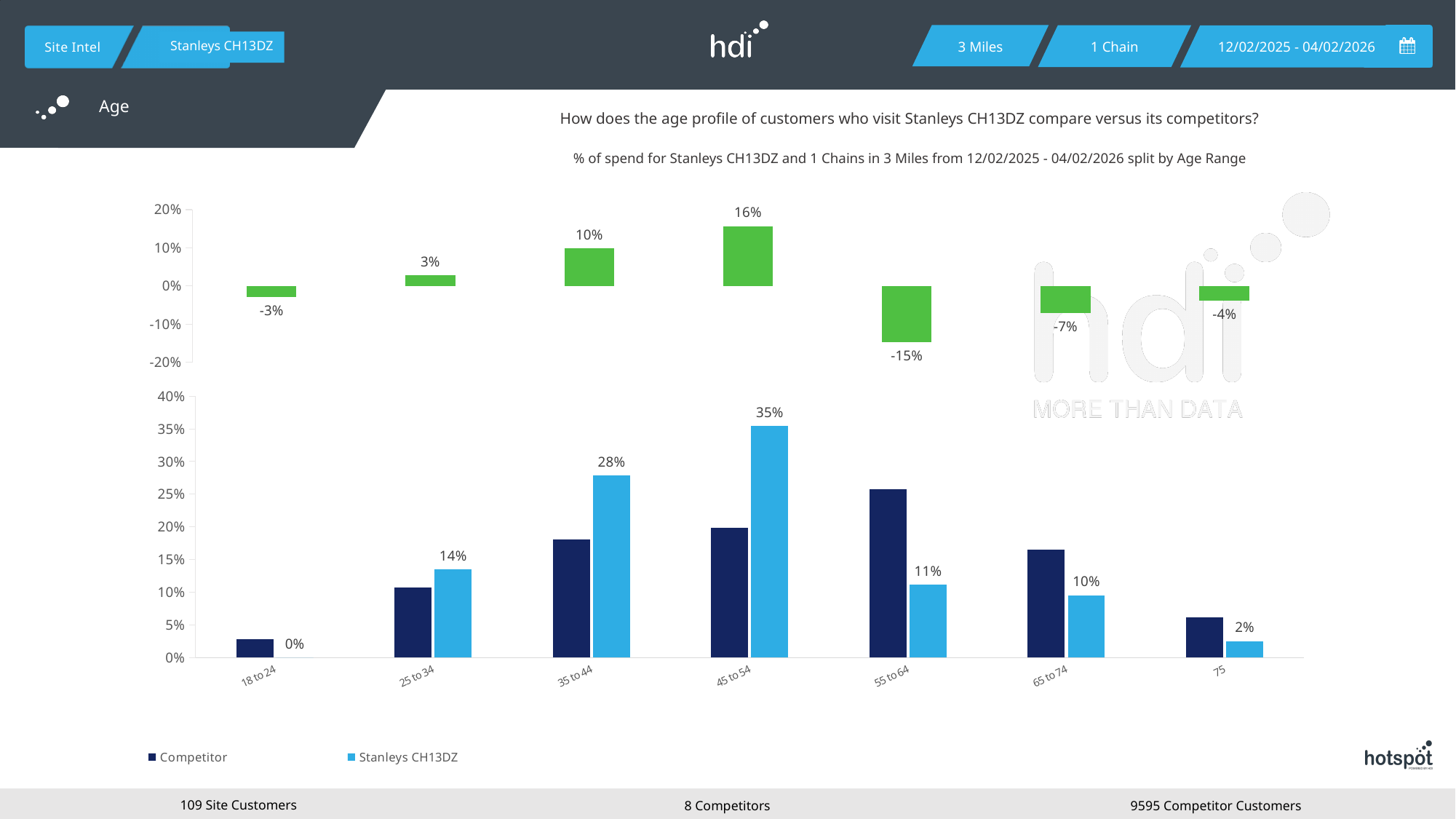
In the bottom chart, what is the value for Stanleys CH13DZ in the 45 to 54 age range? 35% How many age range categories are shown on the x axis of the bottom chart? 7 In the bottom chart, what is the value for Stanleys CH13DZ in the 25 to 34 age range? 14% In the bottom chart, is the Competitor value for 55 to 64 greater or less than 20%? greater In the top chart, which age range has the highest value? 45 to 54 In the bottom chart, for the 55 to 64 age range, which series has the larger value, Competitor or Stanleys CH13DZ? Competitor In the top chart, which age range has the lowest value? 55 to 64 How many series does the legend of the bottom chart list? 2 What kind of chart is the bottom chart? Bar chart In the top chart, what is the value shown for the 55 to 64 age range? -15% In the bottom chart, what is the difference between the Stanleys CH13DZ values for 35 to 44 and 25 to 34? 14% In the bottom chart, which age range has the lowest Stanleys CH13DZ value? 18 to 24